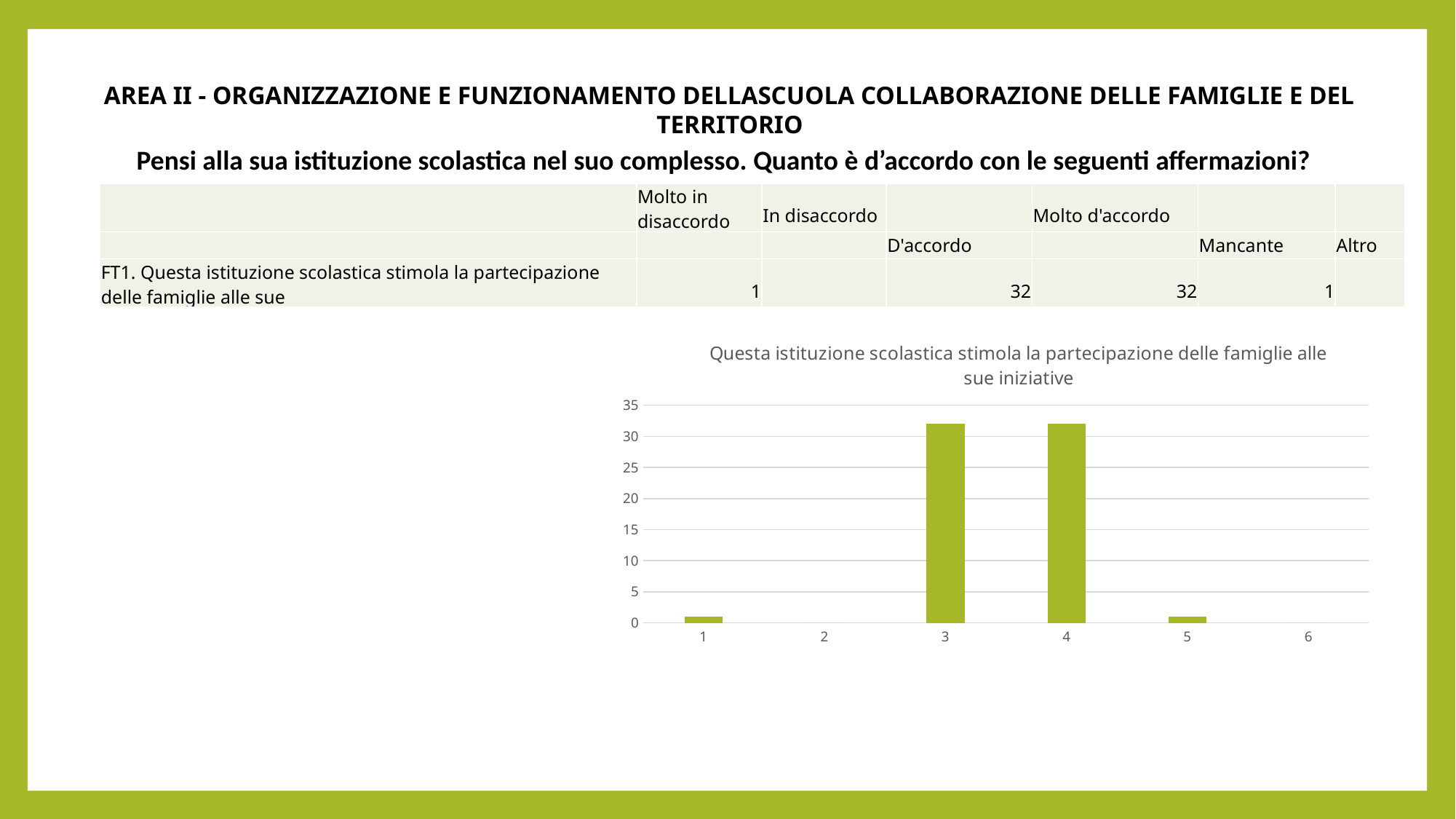
What kind of chart is shown on the slide? bar chart What is the value for category 4 in the chart? 32 What is the value for category 3 in the chart? 32 What is the highest value shown on the y axis of the chart? 35 How many categories in the chart have a visible bar? 4 What is the title of the chart? Questa istituzione scolastica stimola la partecipazione delle famiglie alle sue iniziative What is the value for category 1 in the chart? 1 What is the difference between the value for category 3 and the value for category 1? 31 Is the value for category 5 greater or less than 5? less Is the value for category 3 greater or less than 30? greater How many categories are shown on the x axis of the chart? 6 Which is larger, the value for category 4 or the value for category 5? category 4